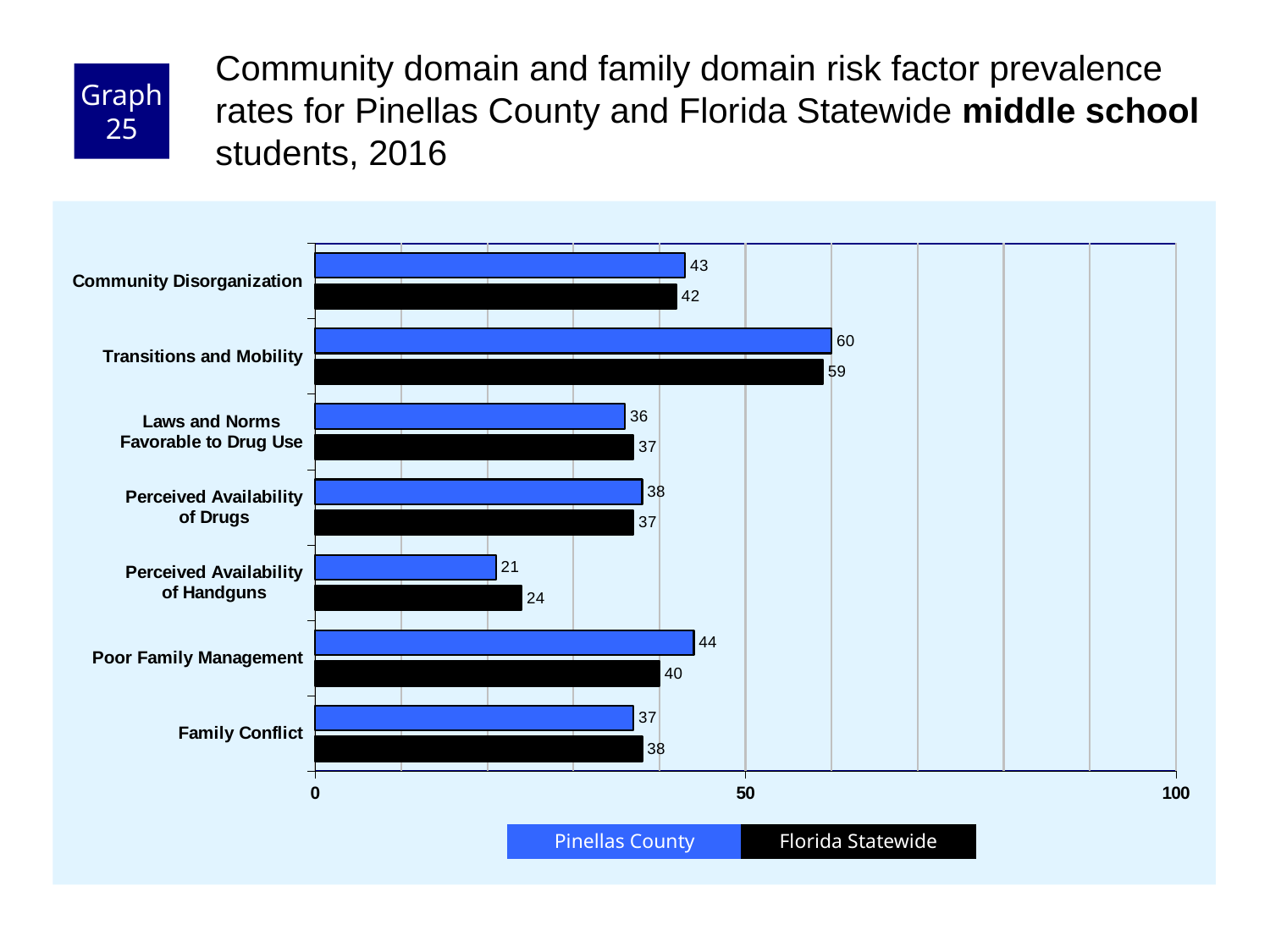
How many series does the legend list? 2 What is the Florida Statewide value for Perceived Availability of Handguns? 24 What kind of chart is shown on the slide? Bar chart For Perceived Availability of Handguns, which is larger: the Pinellas County value or the Florida Statewide value? Florida Statewide Is the Florida Statewide value for Transitions and Mobility greater or less than 50? greater Which colour represents Florida Statewide in the chart? Black Which risk factor has the highest Pinellas County value? Transitions and Mobility What is the Pinellas County value for Poor Family Management? 44 What is the difference between the Pinellas County and Florida Statewide values for Poor Family Management? 4 How many risk factor categories are shown on the chart? 7 Which risk factor has the lowest Florida Statewide value? Perceived Availability of Handguns What is the Pinellas County value for Transitions and Mobility? 60